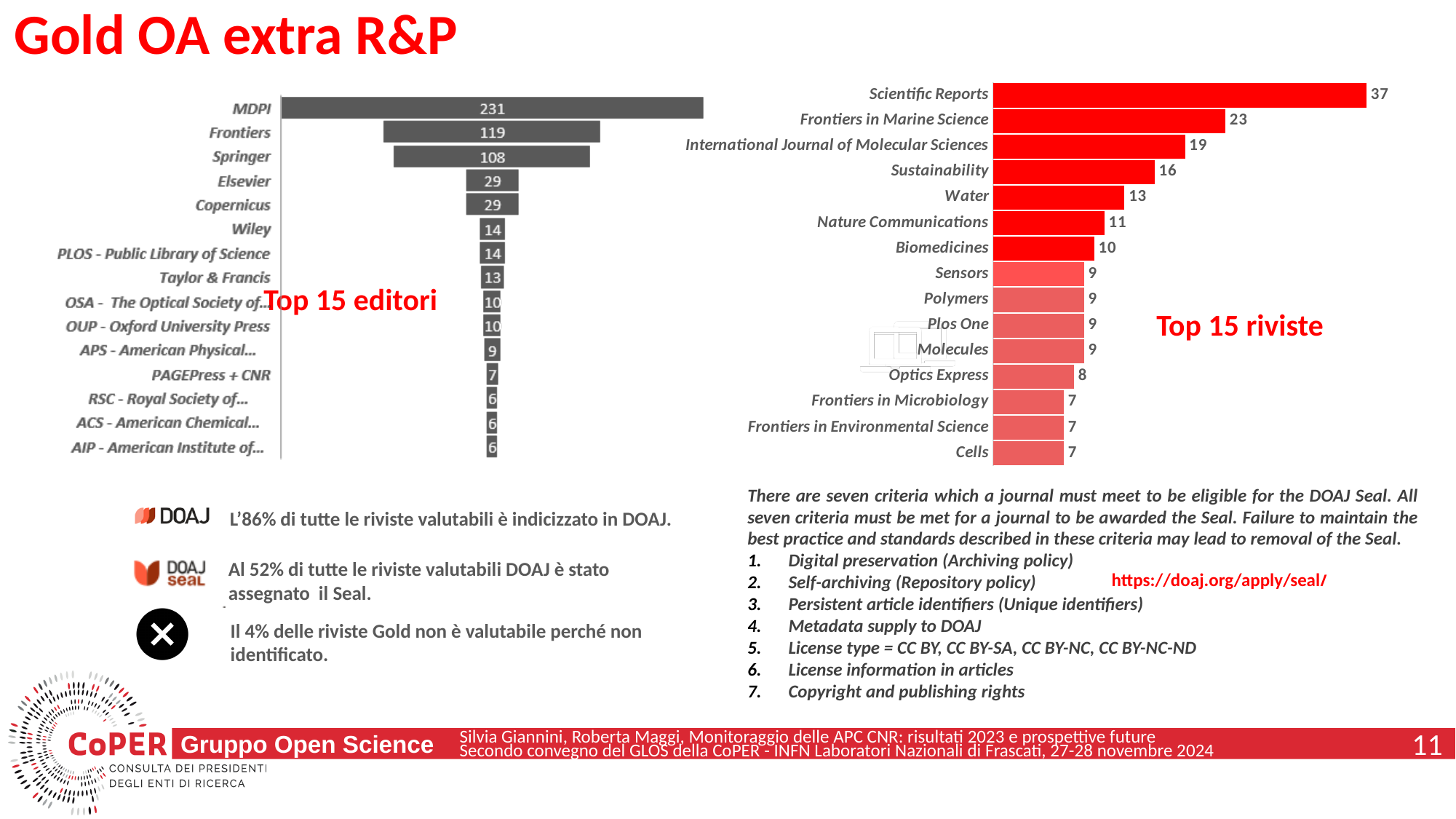
In the 'Top 15 editori' chart, how many publishers are listed? 15 In the 'Top 15 riviste' chart, which is larger, the value for Nature Communications or the value for Optics Express? Nature Communications In the 'Top 15 riviste' chart, which journal has the highest value? Scientific Reports In the 'Top 15 editori' chart, which publisher has the highest value? MDPI In the 'Top 15 editori' chart, what is the value for Springer? 108 In the 'Top 15 editori' chart, which is larger, the value for Elsevier or the value for Wiley? Elsevier What kind of chart is the 'Top 15 riviste' chart? Bar chart In the 'Top 15 riviste' chart, what is the value for Scientific Reports? 37 In the 'Top 15 riviste' chart, what is the difference between the values for Frontiers in Marine Science and Sustainability? 7 In the 'Top 15 riviste' chart, what is the value for Water? 13 In the 'Top 15 editori' chart, what is the value for MDPI? 231 In the 'Top 15 editori' chart, what is the difference between the values for MDPI and Frontiers? 112